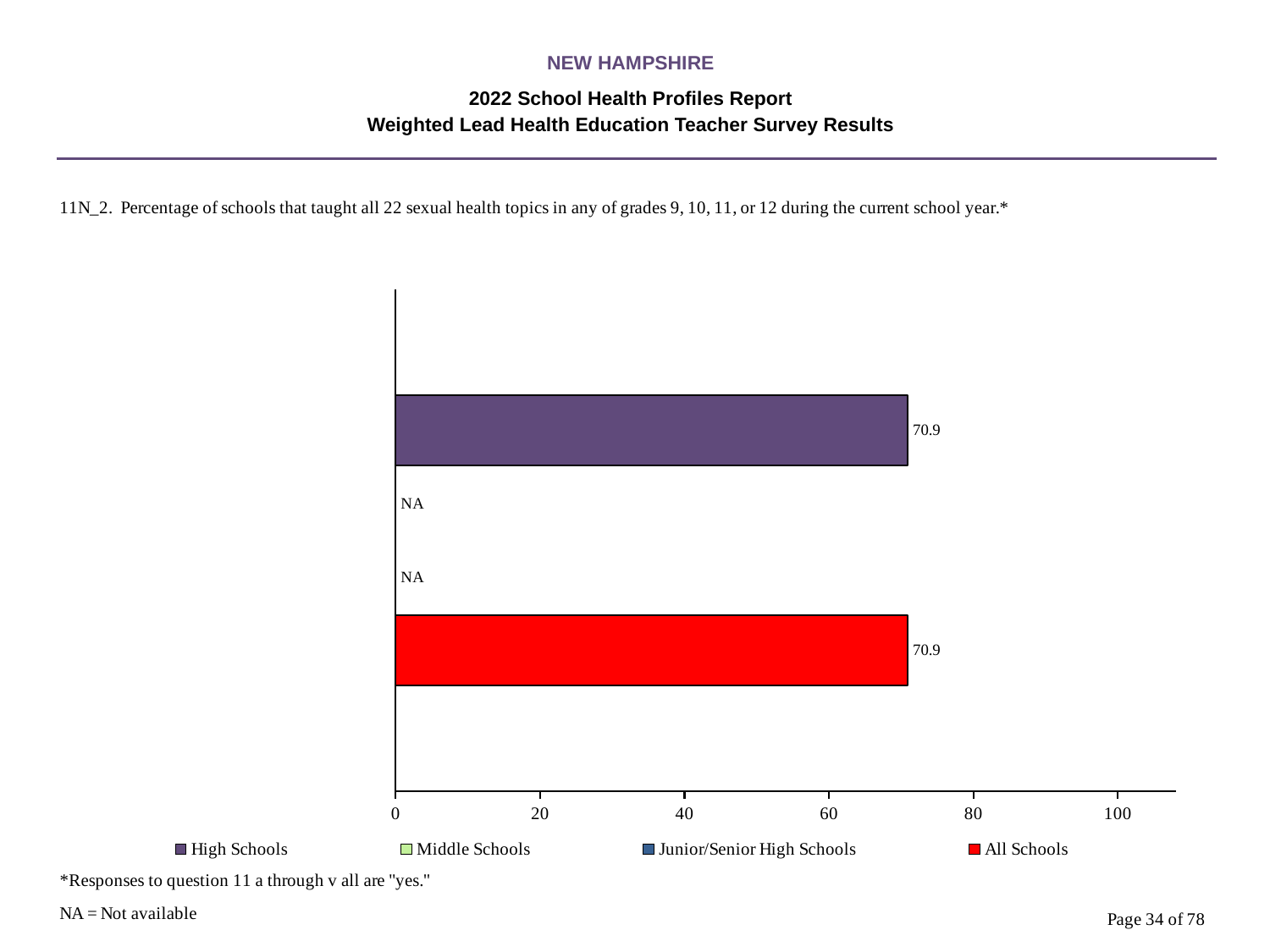
How many series have a plotted bar with a numeric value? 2 How many series does the legend list? 4 What is the maximum value shown on the x axis? 100 What is shown for Middle Schools? NA Is the value for High Schools greater or less than 60? greater What is the value for All Schools? 70.9 What colour is the All Schools bar? red Is the value for All Schools greater or less than 80? less What kind of chart is this? bar chart What is the difference between the High Schools value and the All Schools value? 0 What is the value for High Schools? 70.9 What is shown for Junior/Senior High Schools? NA